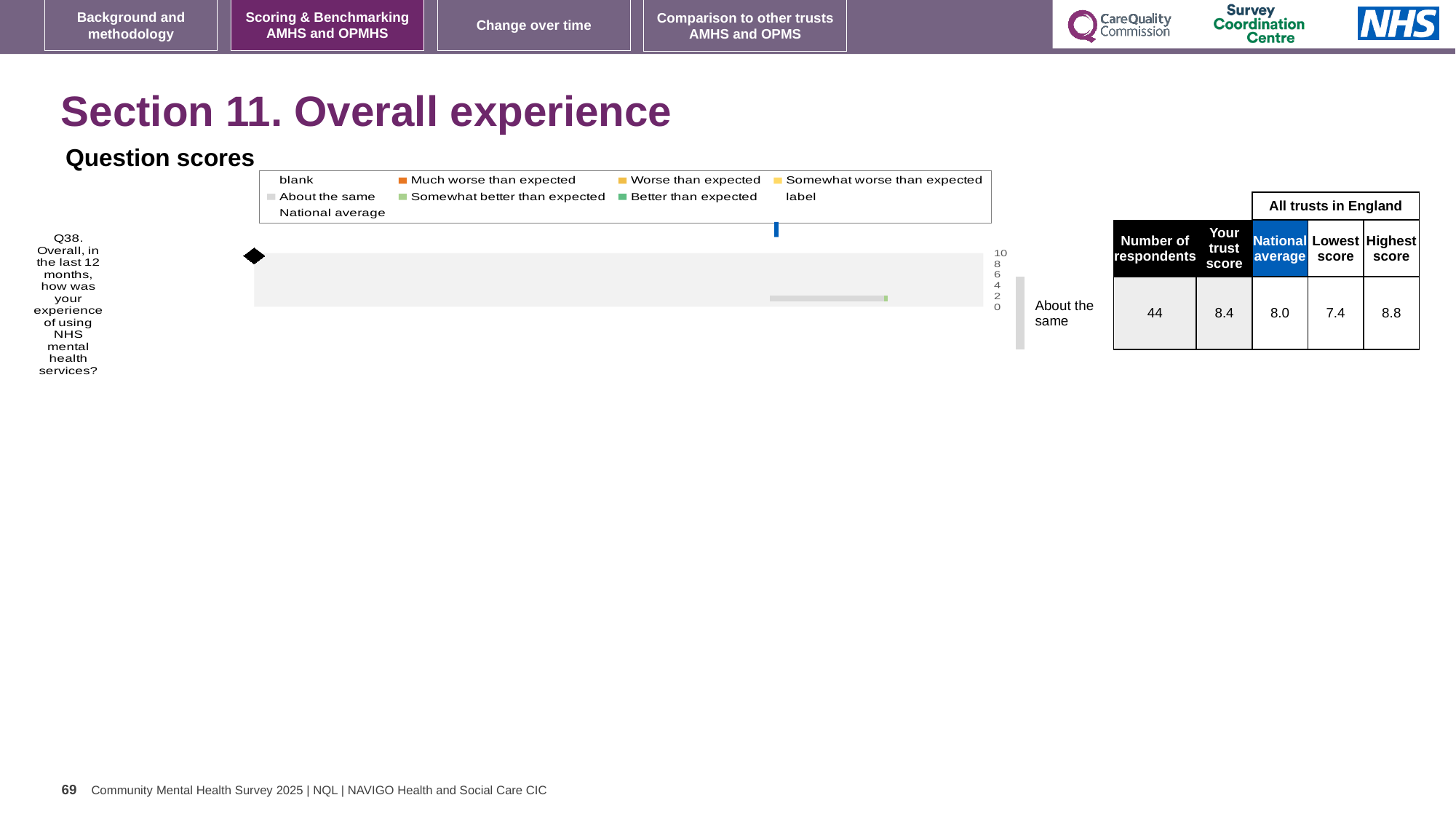
What kind of chart is shown under 'Question scores'? bar chart How many questions are plotted in the 'Question scores' chart? 1 By how much does the trust's score for Q38 exceed the national average? 0.4 What is the national average score for Q38? 8.0 For Q38, which is larger: the trust's score or the national average? the trust's score (8.4) What is the trust's score for Q38 (overall experience of using NHS mental health services)? 8.4 What is the lowest score among all trusts in England for Q38? 7.4 What is the difference between the highest and lowest trust scores for Q38? 1.4 What benchmark category is shown for Q38 next to the chart? About the same What is the highest score among all trusts in England for Q38? 8.8 How many respondents answered Q38? 44 What is the title of the chart on this slide? Question scores